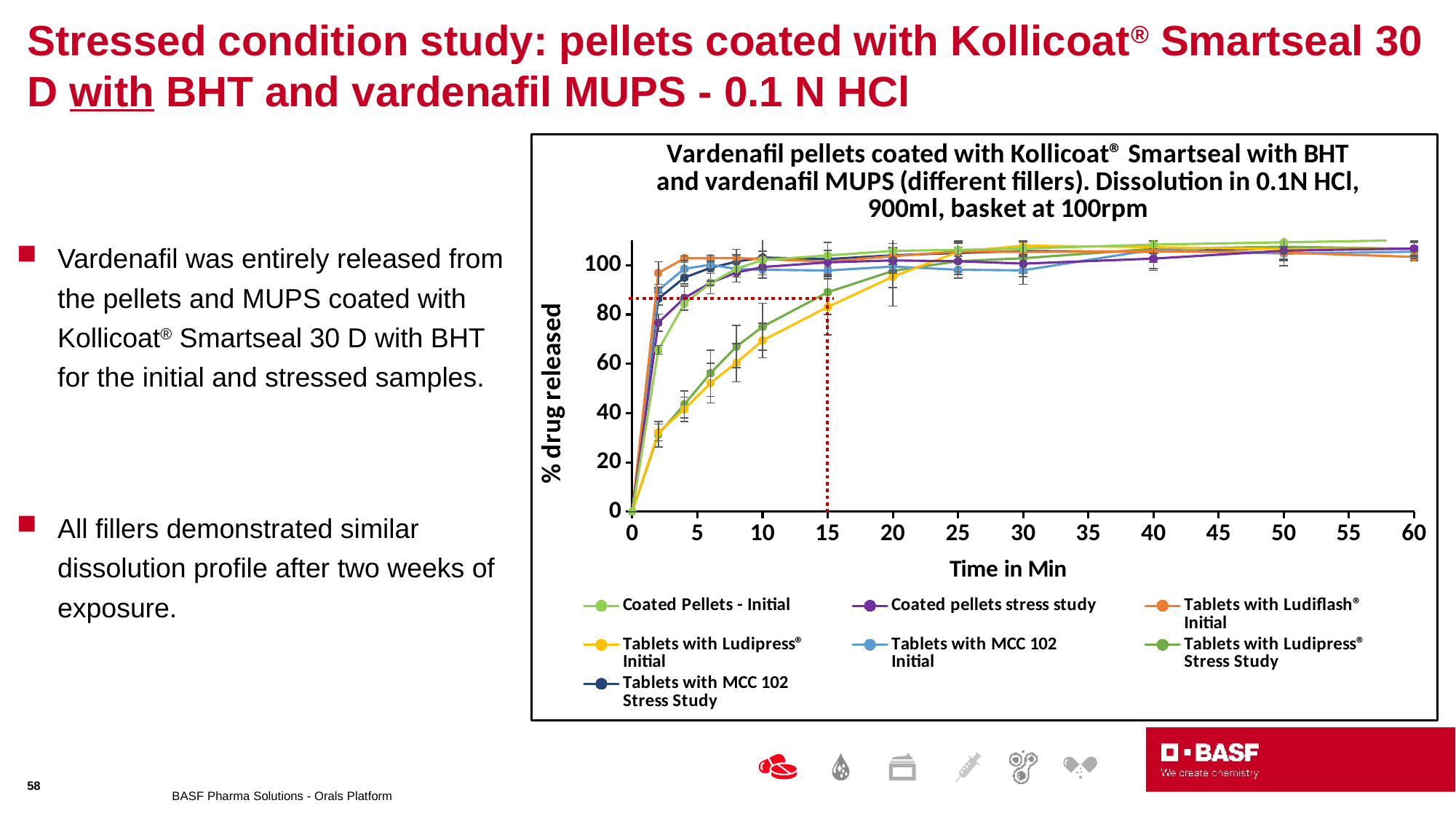
Do the values for Tablets with Ludipress Initial rise or fall as time increases from 0 to 30 minutes? Rise What kind of chart is shown on the slide? Line chart Is the value for Tablets with Ludiflash Initial at 2 minutes greater or less than 80? greater How many series does the chart legend list? 7 What is the label of the y axis of the chart? % drug released At 4 minutes, which is larger: the value for Tablets with Ludiflash Initial or the value for Tablets with Ludipress Stress Study? Tablets with Ludiflash Initial At 10 minutes, which is larger: the value for Coated Pellets - Initial or the value for Tablets with Ludipress Initial? Coated Pellets - Initial What is the label of the x axis of the chart? Time in Min Is the value for Coated Pellets - Initial at 2 minutes greater or less than 40? greater Is the value for Tablets with Ludipress Initial at 10 minutes greater or less than 80? less